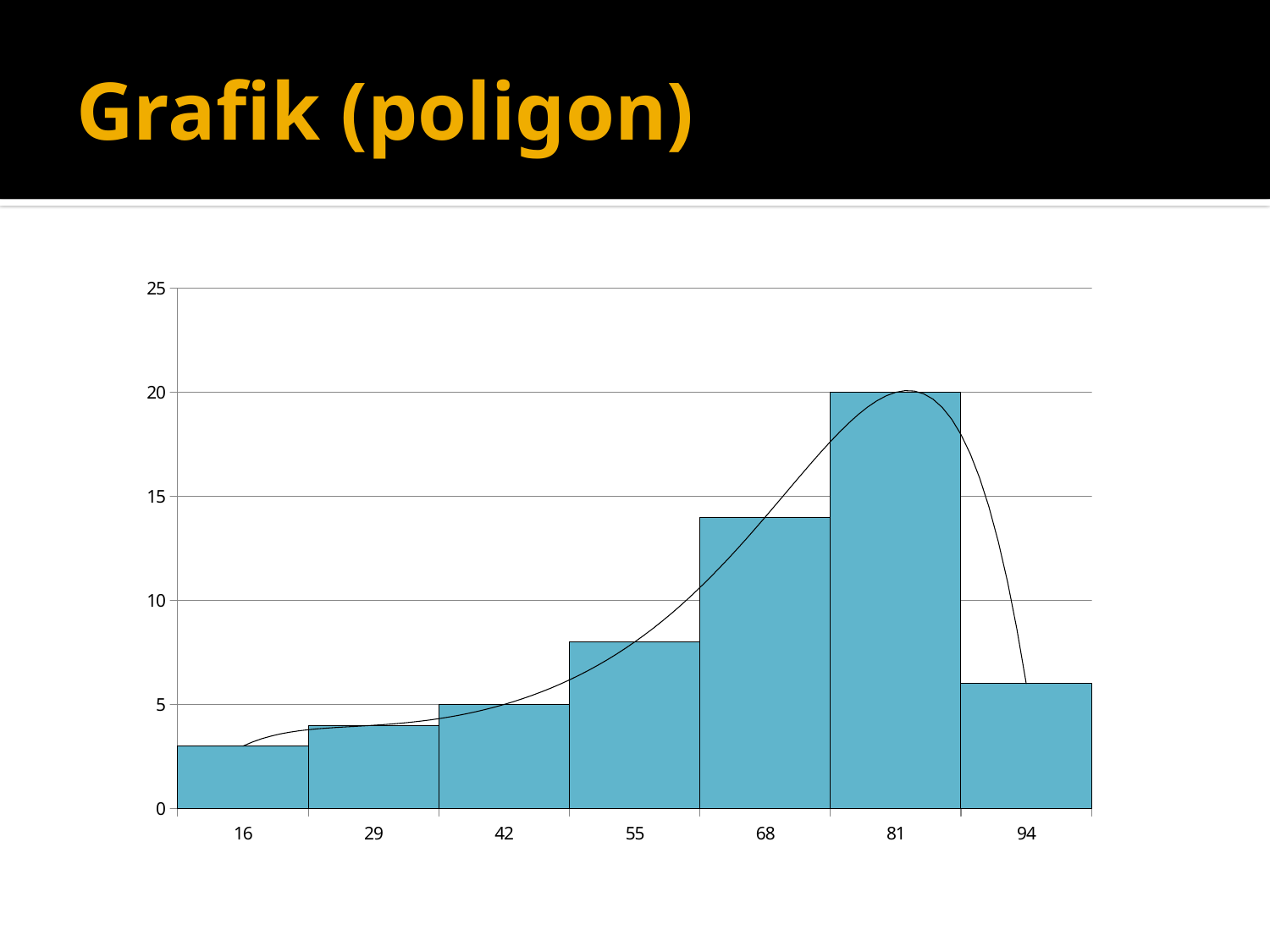
What is the difference between the bar at 81 and the bar at 42? 15 What is the value of the bar at 42? 5 What kind of chart is shown on the slide? Bar chart Is the value for 55 greater or less than 5? greater Is the value for 94 greater or less than 10? less How many bars are shown in the chart? 7 Which bar is taller, 68 or 94? 68 Is the value for 68 greater or less than 10? greater What is the title of the slide? Grafik (poligon) Which category has the lowest bar? 16 What is the value of the bar at 81? 20 Which category has the highest bar? 81